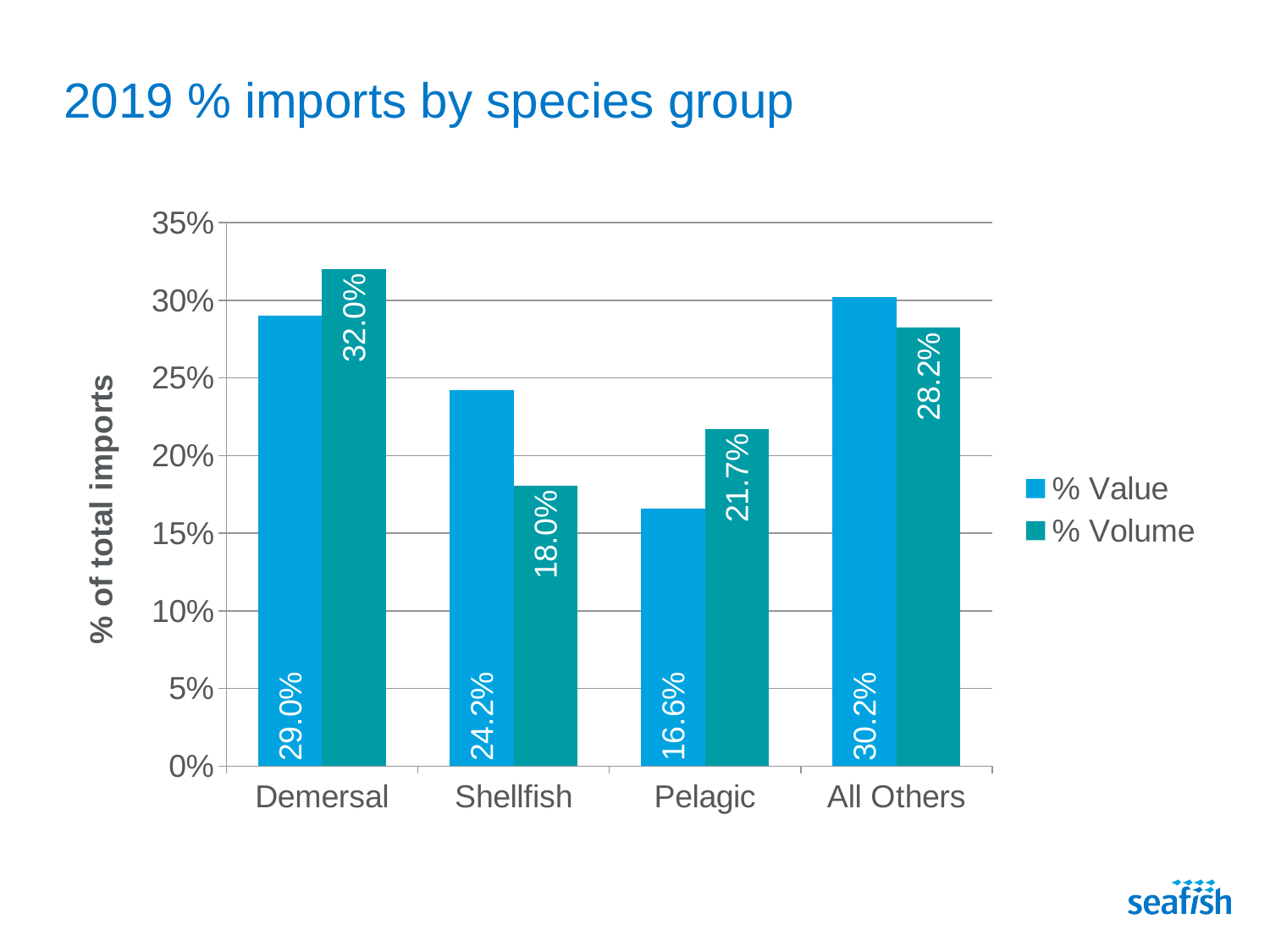
Which species group has the highest % Volume? Demersal How many series does the legend list? 2 What is the % Volume for Shellfish? 18.0% What is the % Value for All Others? 30.2% Which is larger for Shellfish, % Value or % Volume? % Value What type of chart is shown on the slide? Bar chart What is the % Value for Demersal? 29.0% Which species group has the lowest % Value? Pelagic Is the % Volume for All Others greater or less than 25%? greater What is the % Volume for Pelagic? 21.7% How many species groups are shown on the x axis? 4 What is the difference between the % Volume and % Value for Pelagic? 5.1%